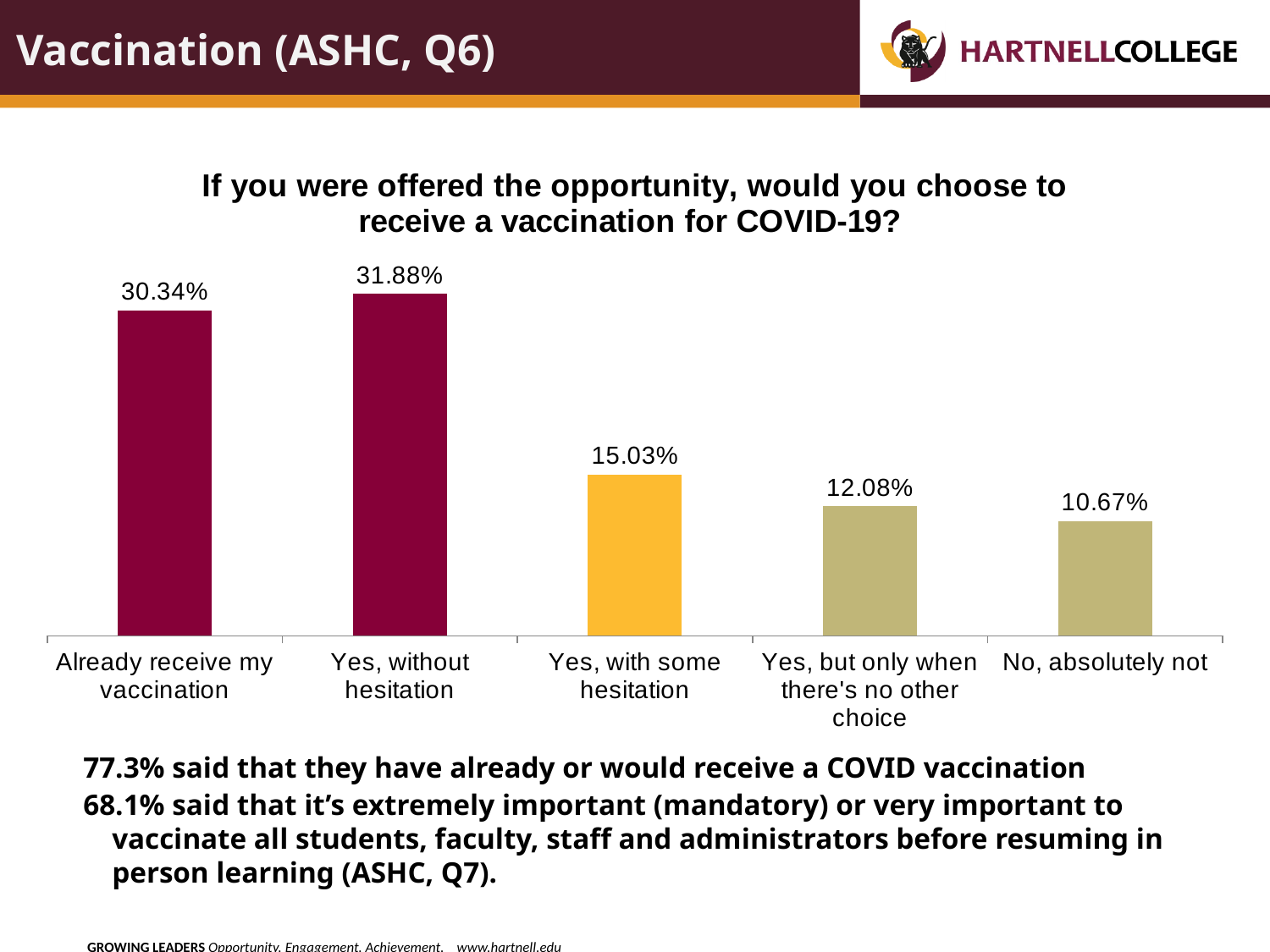
What percentage of respondents answered "Yes, without hesitation"? 31.88% What is the difference in percentage points between "Yes, without hesitation" and "Already receive my vaccination"? 1.54 What percentage of respondents answered "Yes, with some hesitation"? 15.03% Which response category has the highest percentage? Yes, without hesitation How many response categories are shown in the chart? 5 Which is larger: the percentage for "Yes, but only when there's no other choice" or for "No, absolutely not"? Yes, but only when there's no other choice What is the title of the chart? If you were offered the opportunity, would you choose to receive a vaccination for COVID-19? Which response category has the lowest percentage? No, absolutely not What type of chart is shown on the slide? Bar chart What is the difference in percentage points between "Yes, with some hesitation" and "Yes, but only when there's no other choice"? 2.95 What percentage of respondents answered "No, absolutely not"? 10.67% What percentage of respondents said they already receive their vaccination? 30.34%